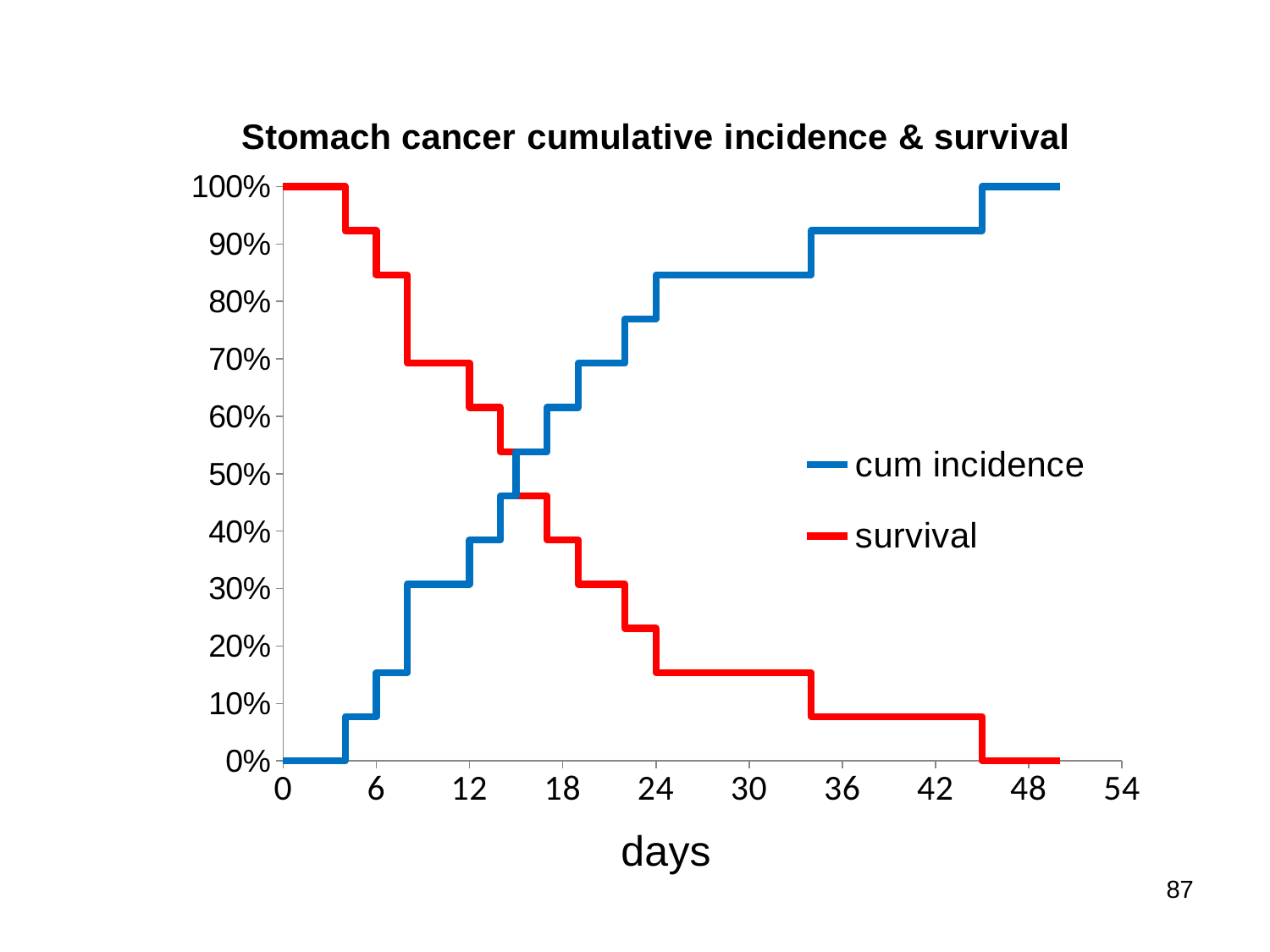
What is the label of the x axis? days How many series does the legend list? 2 What is the value of survival at day 0? 100% Is the value for survival at day 30 greater or less than 20%? less Does the survival series rise or fall as days increase? fall At day 30, which series has the larger value, cum incidence or survival? cum incidence What is the value of survival at the end of the curve (day 50)? 0% What is the value of cum incidence at day 0? 0% What is the value of cum incidence at the end of the curve (day 50)? 100% Does the cum incidence series rise or fall as days increase? rise What is the title of the chart? Stomach cancer cumulative incidence & survival What kind of chart is shown on the slide? line chart